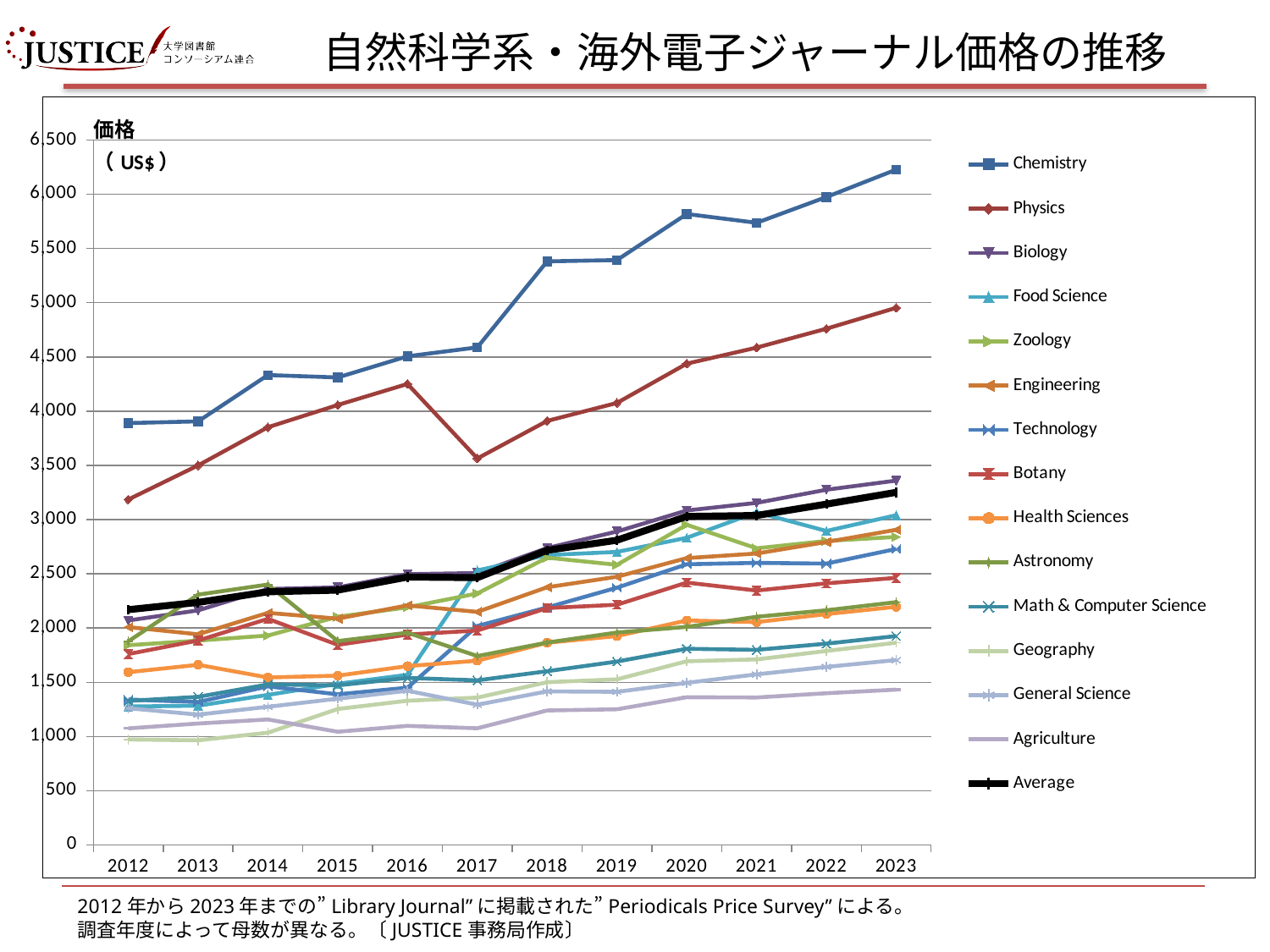
Is the value for Average in 2023 greater or less than 3,000? greater How many years are plotted along the x axis? 12 Does the Chemistry line generally rise or fall from 2012 to 2023? rise What kind of chart is shown on the slide? line chart How many series does the legend list? 15 Is the value for Chemistry in 2023 greater or less than 6,000? greater Which series has the lowest value in 2023? Agriculture Is the value for Physics in 2017 greater or less than 4,000? less Which series has the highest value in 2023? Chemistry Which is larger in 2023, Chemistry or Physics? Chemistry What unit is shown for the price axis? US$